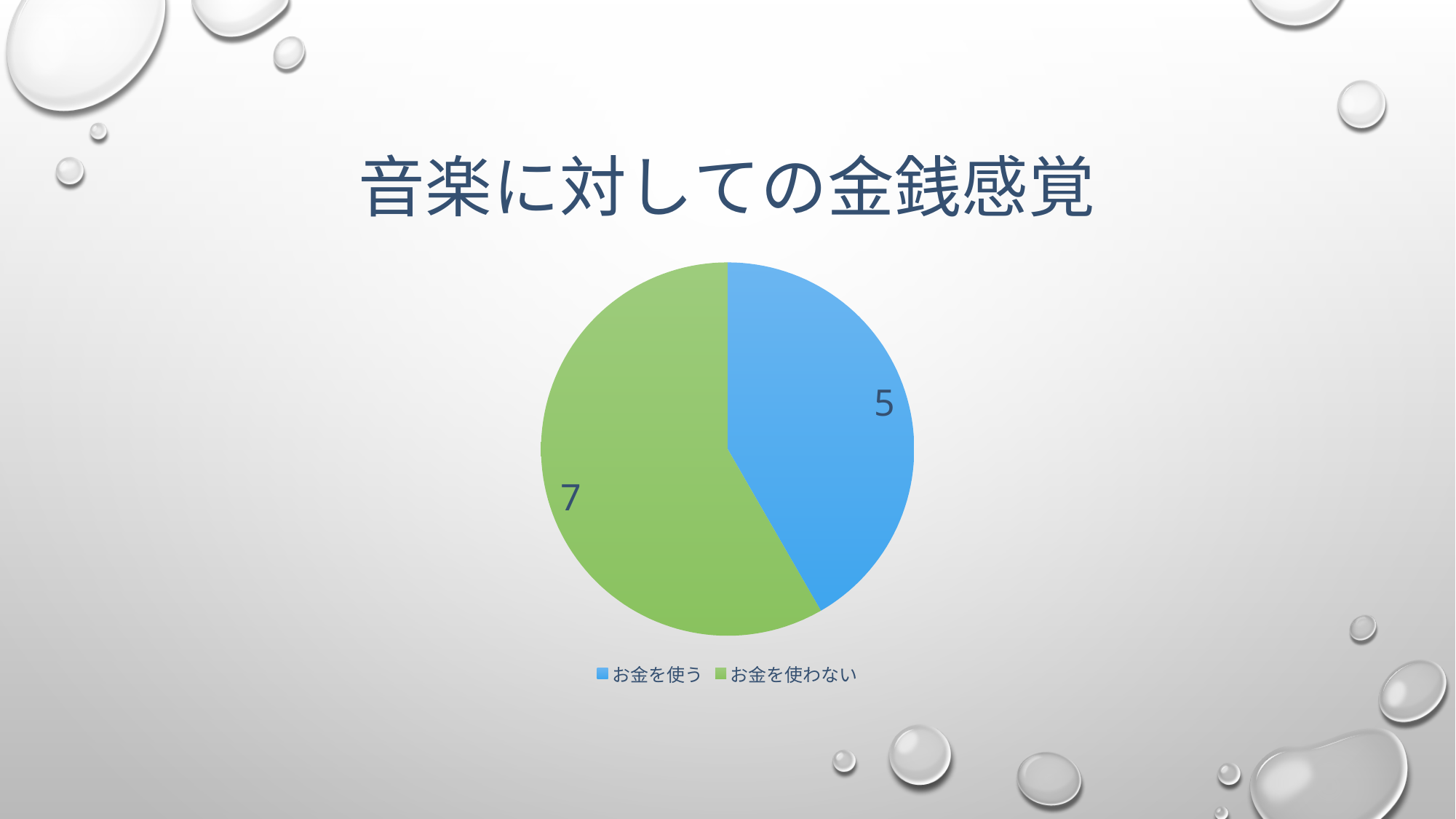
What is the title of the slide? 音楽に対しての金銭感覚 Which category has the smallest slice? お金を使う Which category has the largest slice? お金を使わない What kind of chart is shown on the slide? Pie chart What is the value for お金を使わない? 7 What is the total of all slices in the pie chart? 12 How many entries does the legend list? 2 What colour is the slice for お金を使わない? Green Which is larger, お金を使う or お金を使わない? お金を使わない How many slices does the pie chart have? 2 What is the difference between the values for お金を使わない and お金を使う? 2 What is the value for お金を使う? 5